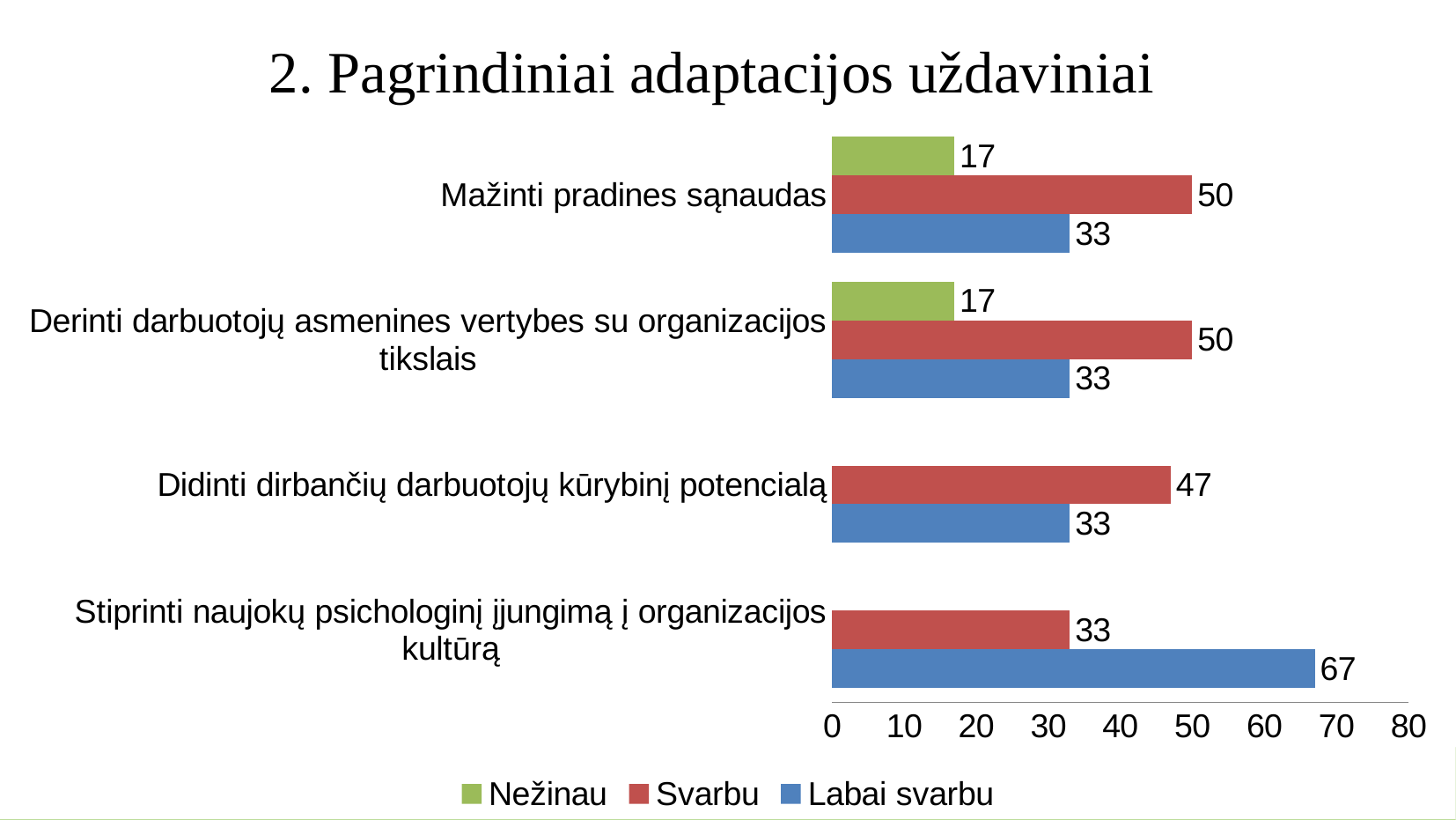
What is the 'Svarbu' value for 'Didinti dirbančių darbuotojų kūrybinį potencialą'? 47 What is the 'Labai svarbu' value for 'Stiprinti naujokų psichologinį įjungimą į organizacijos kultūrą'? 67 How many series does the legend list? 3 What is the title of the chart? 2. Pagrindiniai adaptacijos uždaviniai Which category has the highest 'Labai svarbu' value? Stiprinti naujokų psichologinį įjungimą į organizacijos kultūrą For 'Mažinti pradines sąnaudas', which is larger: the 'Svarbu' value or the 'Labai svarbu' value? Svarbu What is the difference between the 'Labai svarbu' and 'Svarbu' values for 'Stiprinti naujokų psichologinį įjungimą į organizacijos kultūrą'? 34 Is the 'Svarbu' value for 'Derinti darbuotojų asmenines vertybes su organizacijos tikslais' greater or less than 40? greater Which category has the lowest 'Svarbu' value? Stiprinti naujokų psichologinį įjungimą į organizacijos kultūrą How many categories are shown on the chart? 4 What kind of chart is shown on the slide? Bar chart What is the 'Nežinau' value for 'Mažinti pradines sąnaudas'? 17